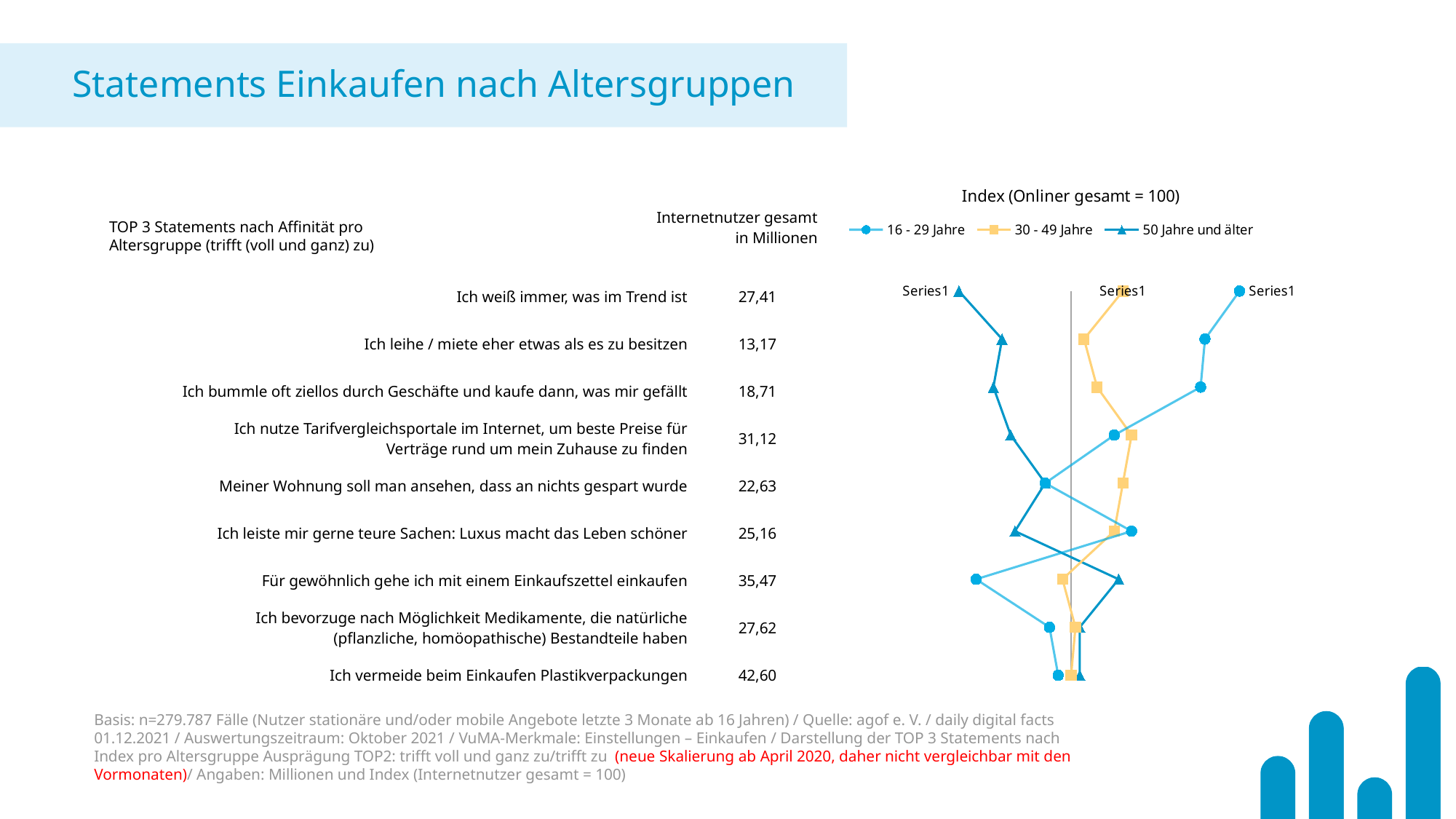
How many statements (categories) are plotted in the chart? 9 Is the index for 16 - 29 Jahre on "Für gewöhnlich gehe ich mit einem Einkaufszettel einkaufen" greater or less than 100? less Which age groups are listed in the chart legend? 16 - 29 Jahre, 30 - 49 Jahre, 50 Jahre und älter Is the index for 16 - 29 Jahre on "Ich weiß immer, was im Trend ist" greater or less than 100? greater For the statement "Ich weiß immer, was im Trend ist", which series has the higher index: 16 - 29 Jahre or 50 Jahre und älter? 16 - 29 Jahre What is the title shown above the chart legend? Index (Onliner gesamt = 100) For the statement "Für gewöhnlich gehe ich mit einem Einkaufszettel einkaufen", which series has the higher index: 16 - 29 Jahre or 50 Jahre und älter? 50 Jahre und älter What is the value in millions of Internetnutzer gesamt for "Ich vermeide beim Einkaufen Plastikverpackungen"? 42,60 What kind of chart is shown on the slide? line chart How many series does the chart legend list? 3 Is the index for 50 Jahre und älter on "Ich leihe / miete eher etwas als es zu besitzen" greater or less than 100? less Which statement has the lowest value of Internetnutzer gesamt in Millionen? Ich leihe / miete eher etwas als es zu besitzen